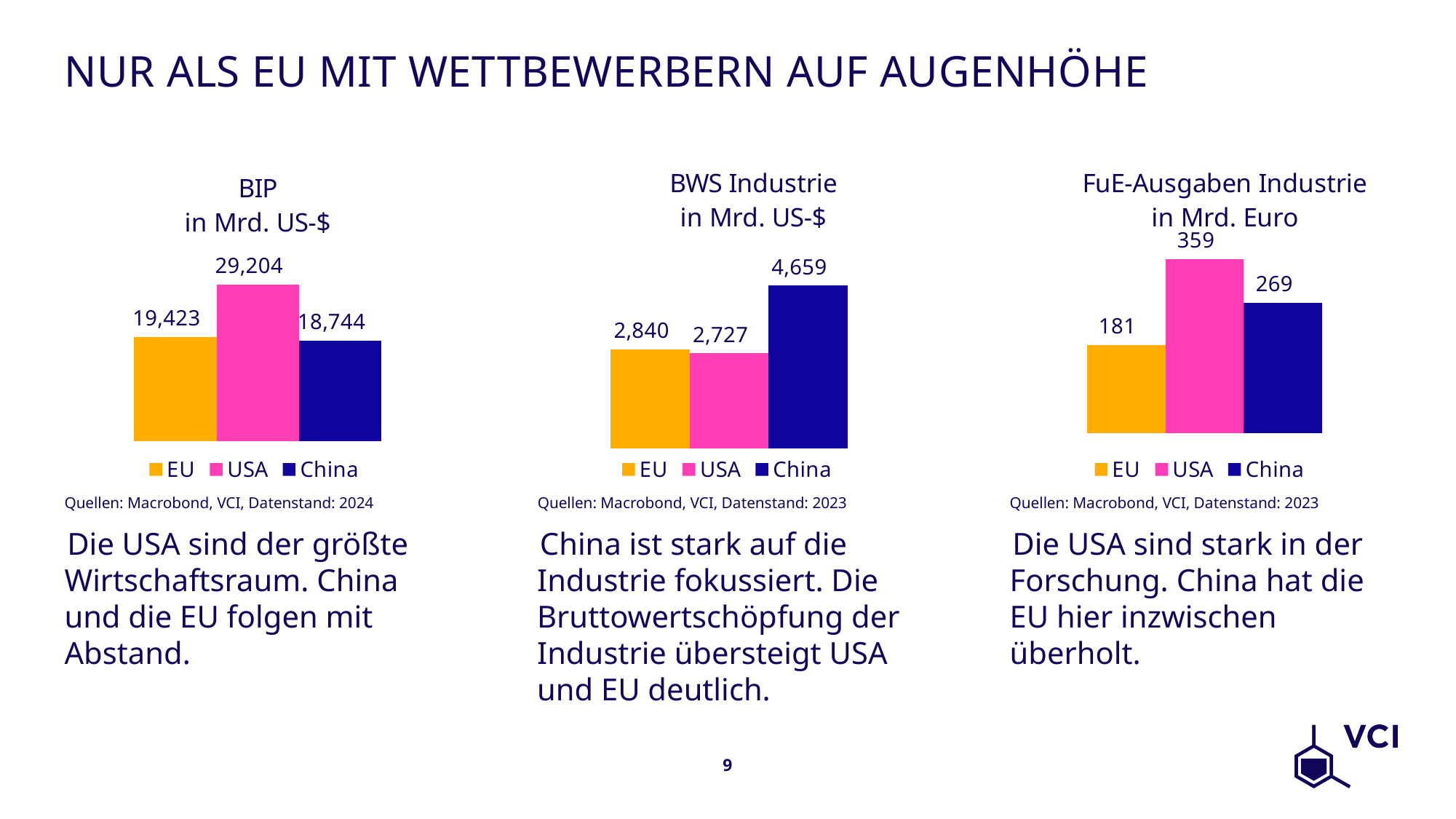
What kind of chart is the 'BWS Industrie in Mrd. US-$' chart? Bar chart In the 'FuE-Ausgaben Industrie in Mrd. Euro' chart, which colour represents the USA? Pink In the 'BIP in Mrd. US-$' chart, which region has the lowest value? China In the 'FuE-Ausgaben Industrie in Mrd. Euro' chart, what is the difference between the USA and China values? 90 In the 'BWS Industrie in Mrd. US-$' chart, what is the difference between the EU and USA values? 113 How many series does the legend of the 'BIP in Mrd. US-$' chart list? 3 In the 'BWS Industrie in Mrd. US-$' chart, what is the value for China? 4,659 In the 'BIP in Mrd. US-$' chart, what is the value for the USA? 29,204 In the 'FuE-Ausgaben Industrie in Mrd. Euro' chart, which is larger, the value for China or the value for the EU? China In the 'BIP in Mrd. US-$' chart, what is the difference between the USA and EU values? 9,781 In the 'FuE-Ausgaben Industrie in Mrd. Euro' chart, what is the value for the EU? 181 In the 'BWS Industrie in Mrd. US-$' chart, which region has the highest value? China